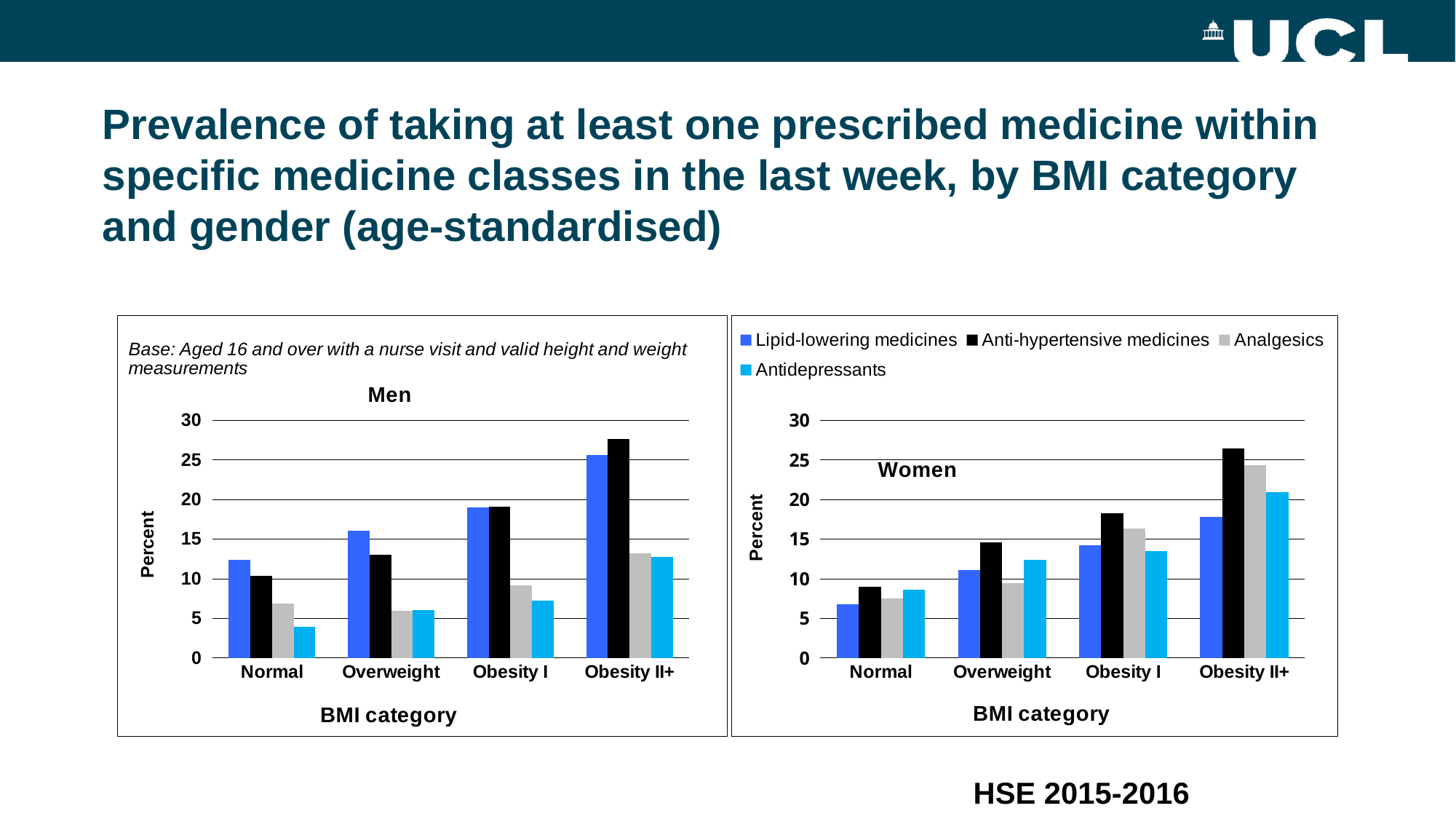
What is the label on the y axis of the Men chart? Percent In the Men chart, which BMI category has the highest value for Lipid-lowering medicines? Obesity II+ How many series does the legend on the Women chart list? 4 What kind of chart is the Men chart? bar chart How many BMI categories are shown on the x axis of the Men chart? 4 In the Women chart, which BMI category has the lowest value for Lipid-lowering medicines? Normal In the Women chart, do the values for Anti-hypertensive medicines rise or fall from Normal to Obesity II+? rise What colour represents Anti-hypertensive medicines in the legend? black In the Men chart, is the value for Antidepressants in the Normal category greater or less than 5? less In the Men chart, is the value for Anti-hypertensive medicines in the Obesity II+ category greater or less than 25? greater In the Women chart, for the Obesity II+ category, which is larger: Anti-hypertensive medicines or Lipid-lowering medicines? Anti-hypertensive medicines In the Women chart, is the value for Analgesics in the Obesity I category greater or less than 15? greater